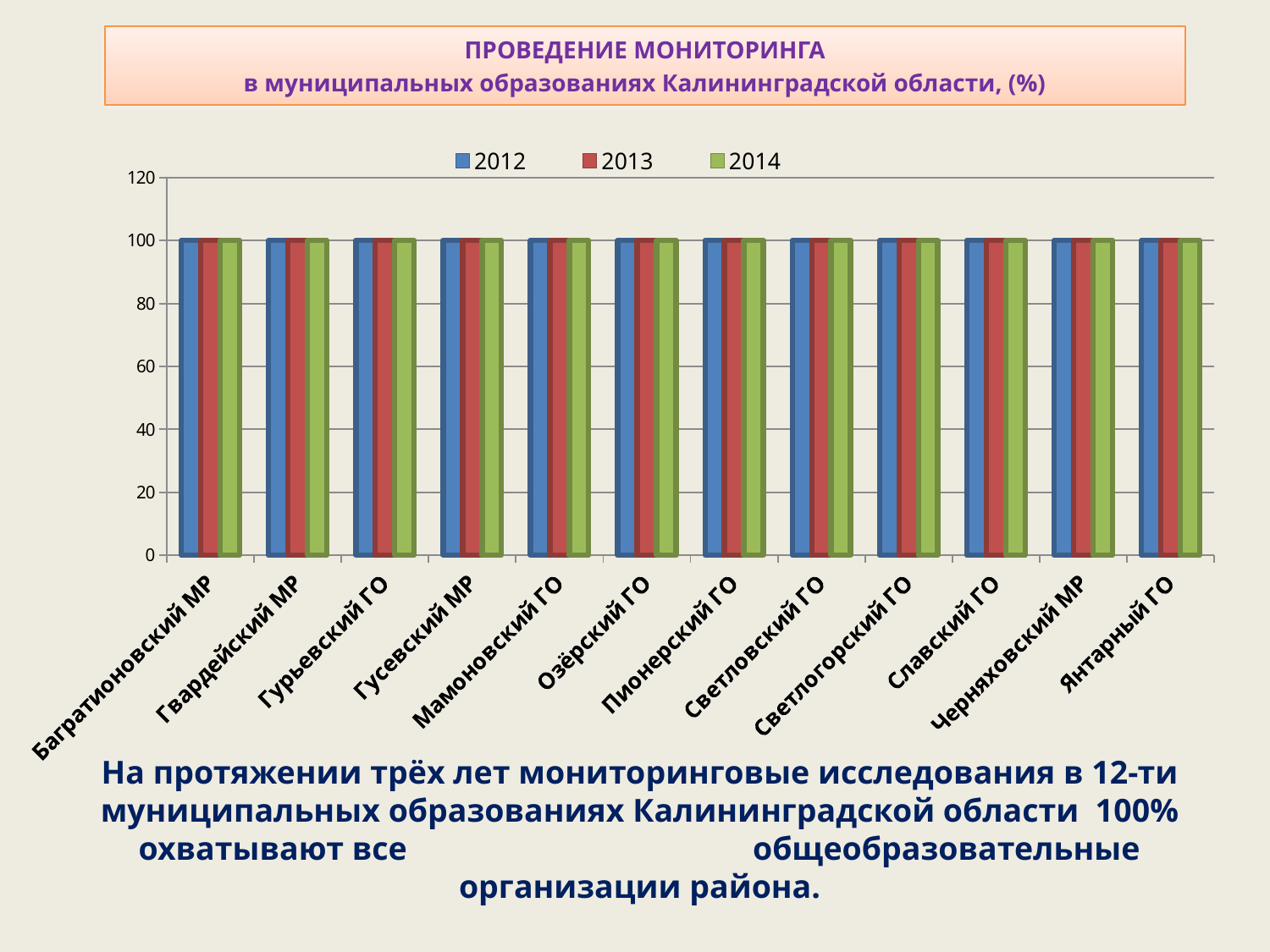
What is the value for Янтарный ГО in 2014? 100 How many series does the legend list? 3 What kind of chart is shown on the slide? bar chart Is the value for Гусевский МР in 2013 greater or less than 80? greater What is the value for Озёрский ГО in 2013? 100 What is the value for Черняховский МР in 2012? 100 What is the value for Багратионовский МР in 2012? 100 What is the highest value shown on the y axis? 120 Which years are listed in the legend? 2012, 2013, 2014 What is the difference between the 2012 and 2014 values for Славский ГО? 0 Do the 2014 values rise, fall, or stay the same across the categories along the x axis? stay the same How many municipal entities (categories) are shown on the x axis? 12